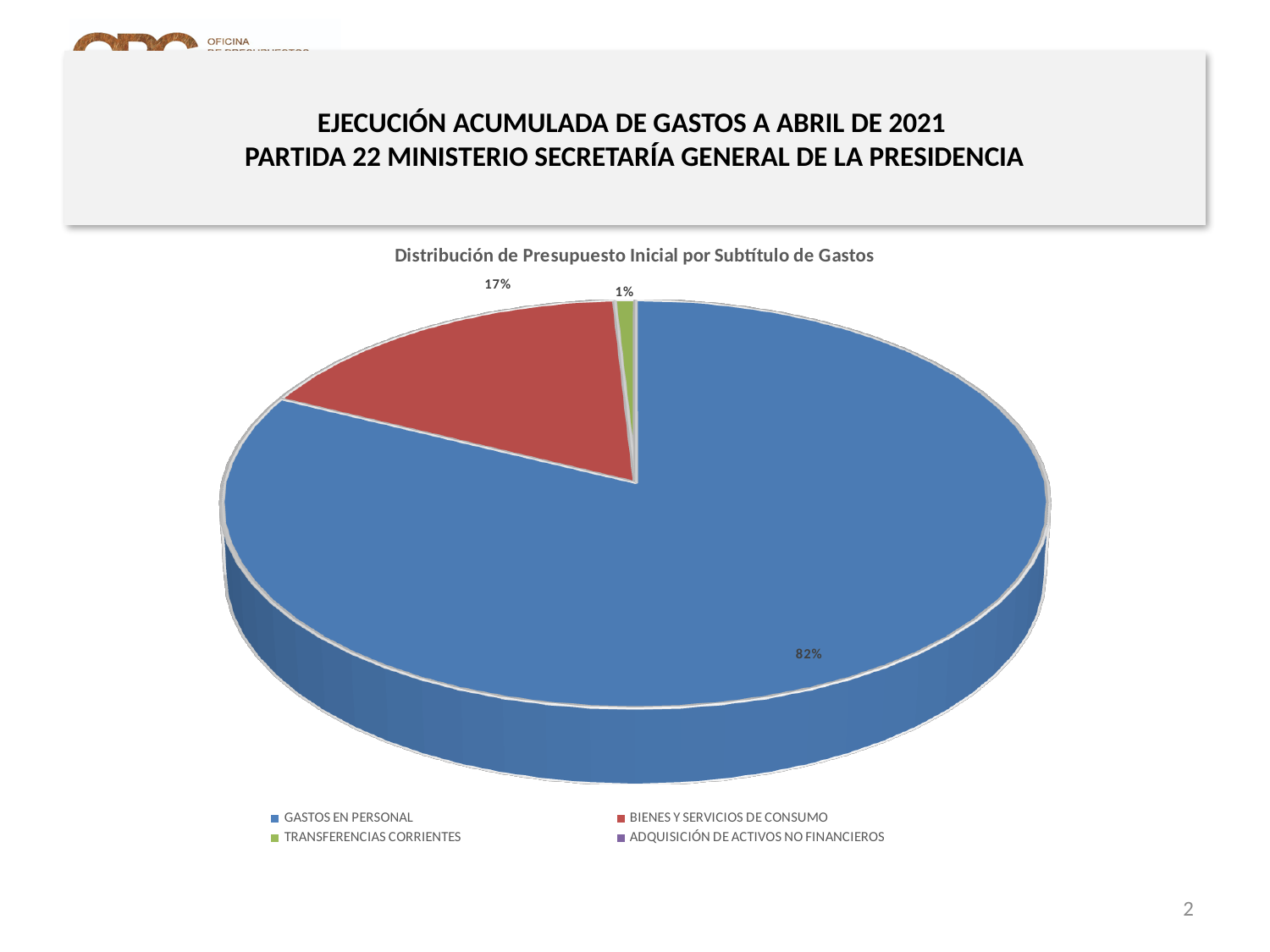
What share of the pie does TRANSFERENCIAS CORRIENTES represent? 1% What kind of chart is shown on the slide? Pie chart What colour is the GASTOS EN PERSONAL slice? Blue What is the difference in percentage points between the GASTOS EN PERSONAL slice and the BIENES Y SERVICIOS DE CONSUMO slice? 65 percentage points What share of the pie does BIENES Y SERVICIOS DE CONSUMO represent? 17% How many entries does the chart legend list? 4 How many slices of the pie have a percentage label? 3 What share of the pie does GASTOS EN PERSONAL represent? 82% Which is larger, the BIENES Y SERVICIOS DE CONSUMO slice or the TRANSFERENCIAS CORRIENTES slice? BIENES Y SERVICIOS DE CONSUMO Which category has the largest slice of the pie? GASTOS EN PERSONAL Which labelled slice of the pie is the smallest? TRANSFERENCIAS CORRIENTES What is the title of the chart? Distribución de Presupuesto Inicial por Subtítulo de Gastos